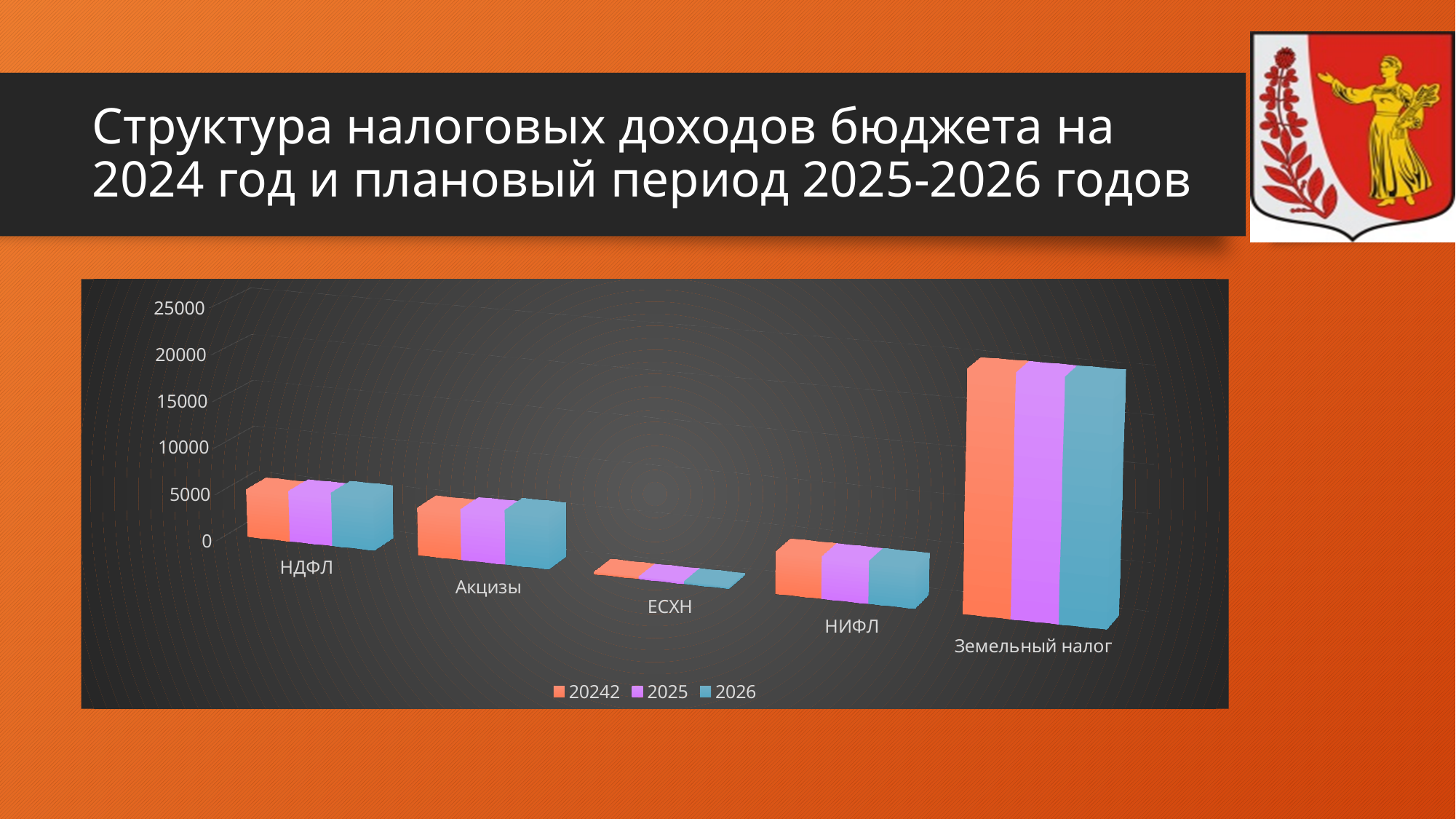
Which category has the lowest values in the chart? ЕСХН Which is larger, the value for НДФЛ or the value for ЕСХН? НДФЛ How many series does the chart legend list? 3 What kind of chart is shown on the slide? bar chart What are the three entries listed in the chart legend? 20242, 2025, 2026 How many tax categories are shown on the x axis of the chart? 5 Is the value for Акцизы greater or less than 10000? less Which category has the highest values in the chart? Земельный налог Is the value for Земельный налог greater or less than 10000? greater Is the value for ЕСХН greater or less than 5000? less What is the highest value shown on the chart's vertical axis? 25000